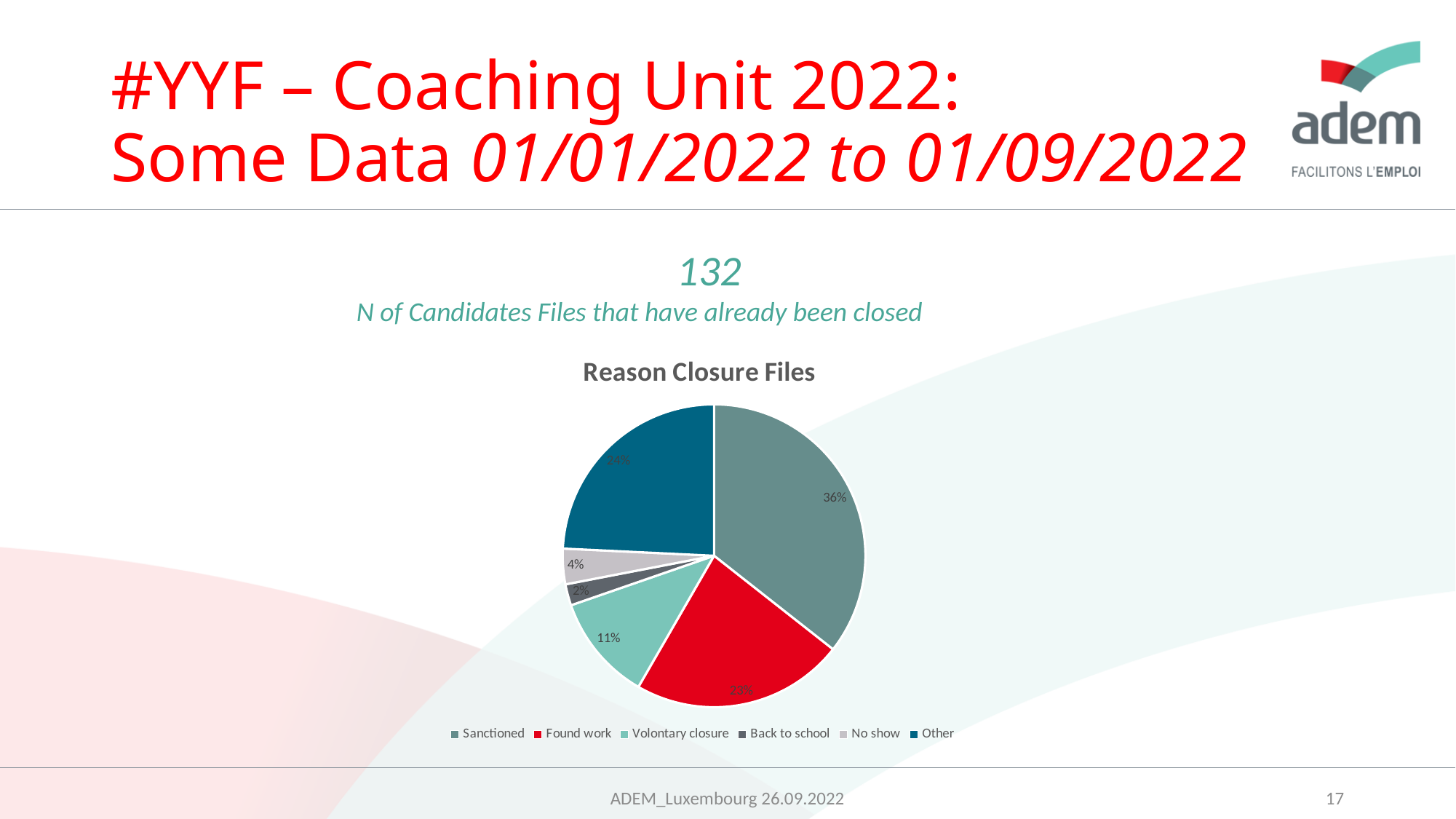
What share of the pie is labelled Found work? 23% Which closure reason has the smallest share of the pie? Back to school What share of the pie is labelled Sanctioned? 36% What type of chart is shown on the slide? pie chart What share of the pie is labelled No show? 4% What is the difference in percentage points between the Sanctioned and Found work slices? 13 What share of the pie is labelled Other? 24% How many categories does the legend list? 6 What is the title of the chart? Reason Closure Files What share of the pie is labelled Voluntary closure? 11% Which slice is larger, Other or Voluntary closure? Other Which closure reason has the largest share of the pie? Sanctioned